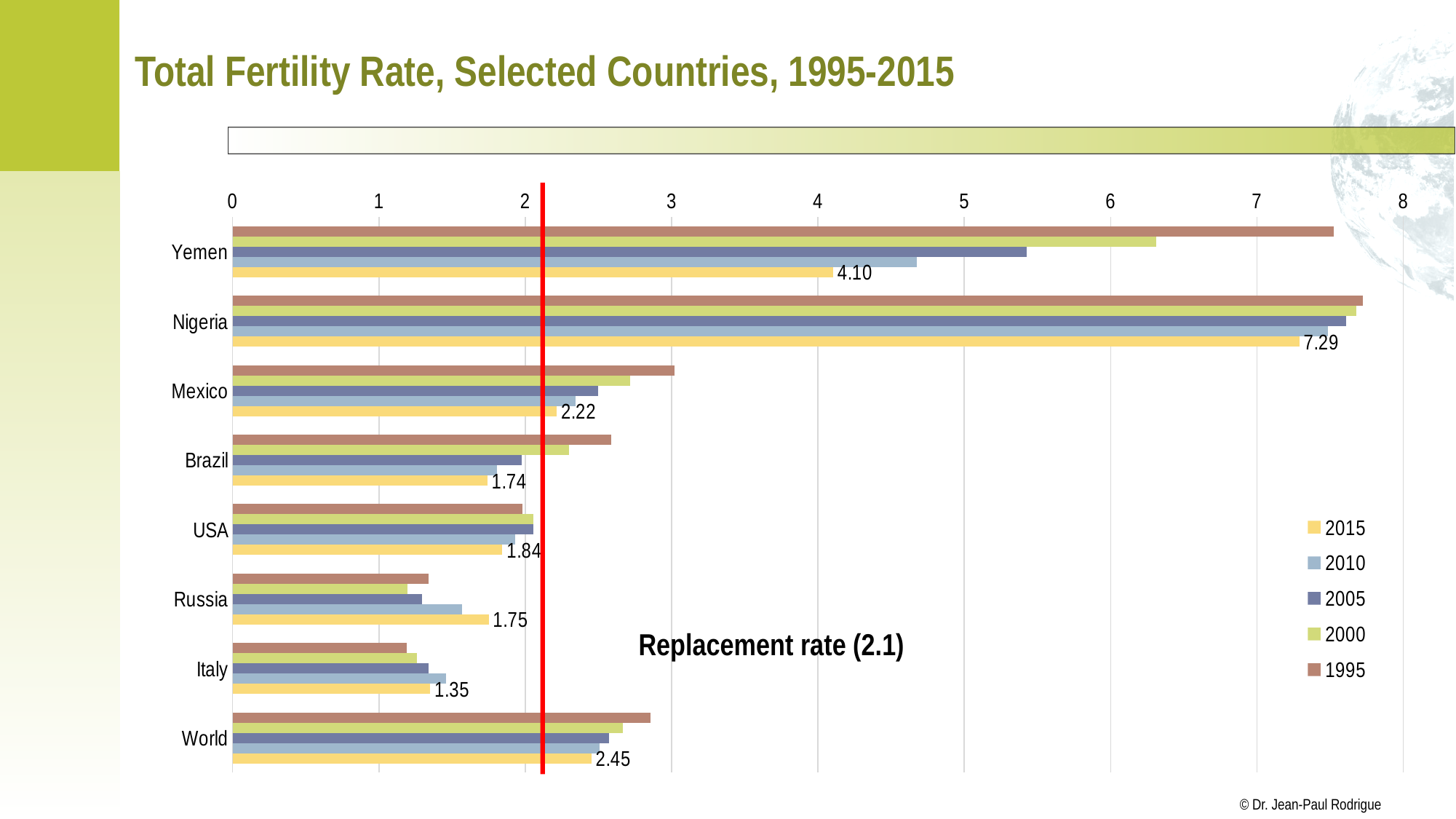
Which category has the lowest total fertility rate in 2015? Italy Is the 1995 value for Russia greater or less than 2? less Which country has the highest total fertility rate in 2015? Nigeria How many series does the legend list? 5 Is the 1995 value for Yemen greater or less than 7? greater What is the 2015 value shown for Italy? 1.35 How many countries or categories are shown on the chart? 8 What is the 2015 value shown for World? 2.45 What is the total fertility rate for Nigeria in 2015? 7.29 What is the total fertility rate for Yemen in 2015? 4.10 Which has the larger 2015 value, USA or Russia? USA What is the difference between the 2015 values for Nigeria and Yemen? 3.19